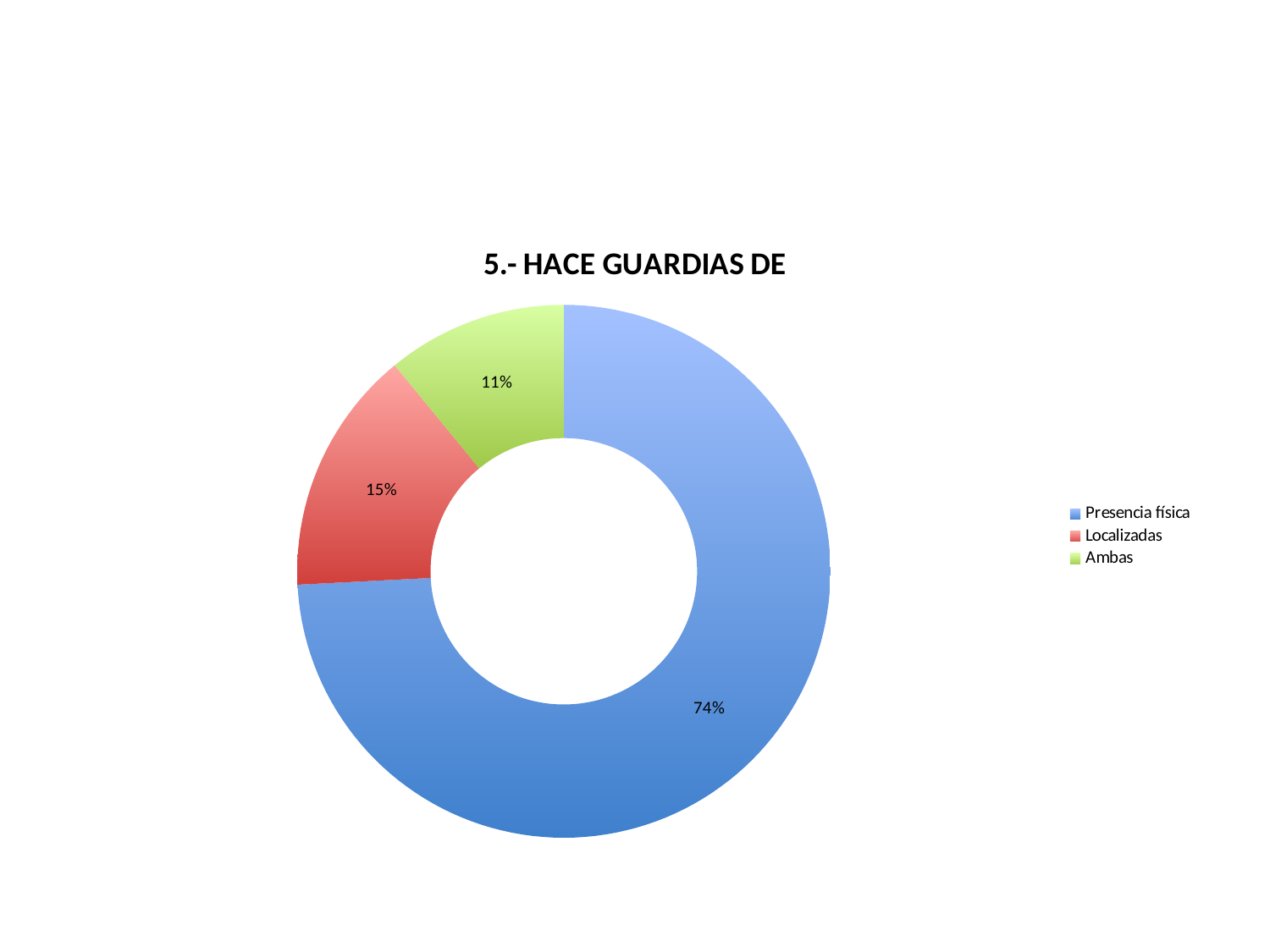
Which is larger, the share for Localizadas or the share for Ambas? Localizadas Which category has the smallest share of the chart? Ambas What percentage of the chart does Presencia física represent? 74% Which category has the largest share of the chart? Presencia física What is the difference in percentage points between Presencia física and Localizadas? 59 What percentage of the chart does Localizadas represent? 15% What is the difference in percentage points between Localizadas and Ambas? 4 How many categories are shown in the chart? 3 What kind of chart is shown on the slide? Doughnut chart What colour represents Localizadas in the chart? Red What percentage of the chart does Ambas represent? 11% What is the title of the chart? 5.- HACE GUARDIAS DE